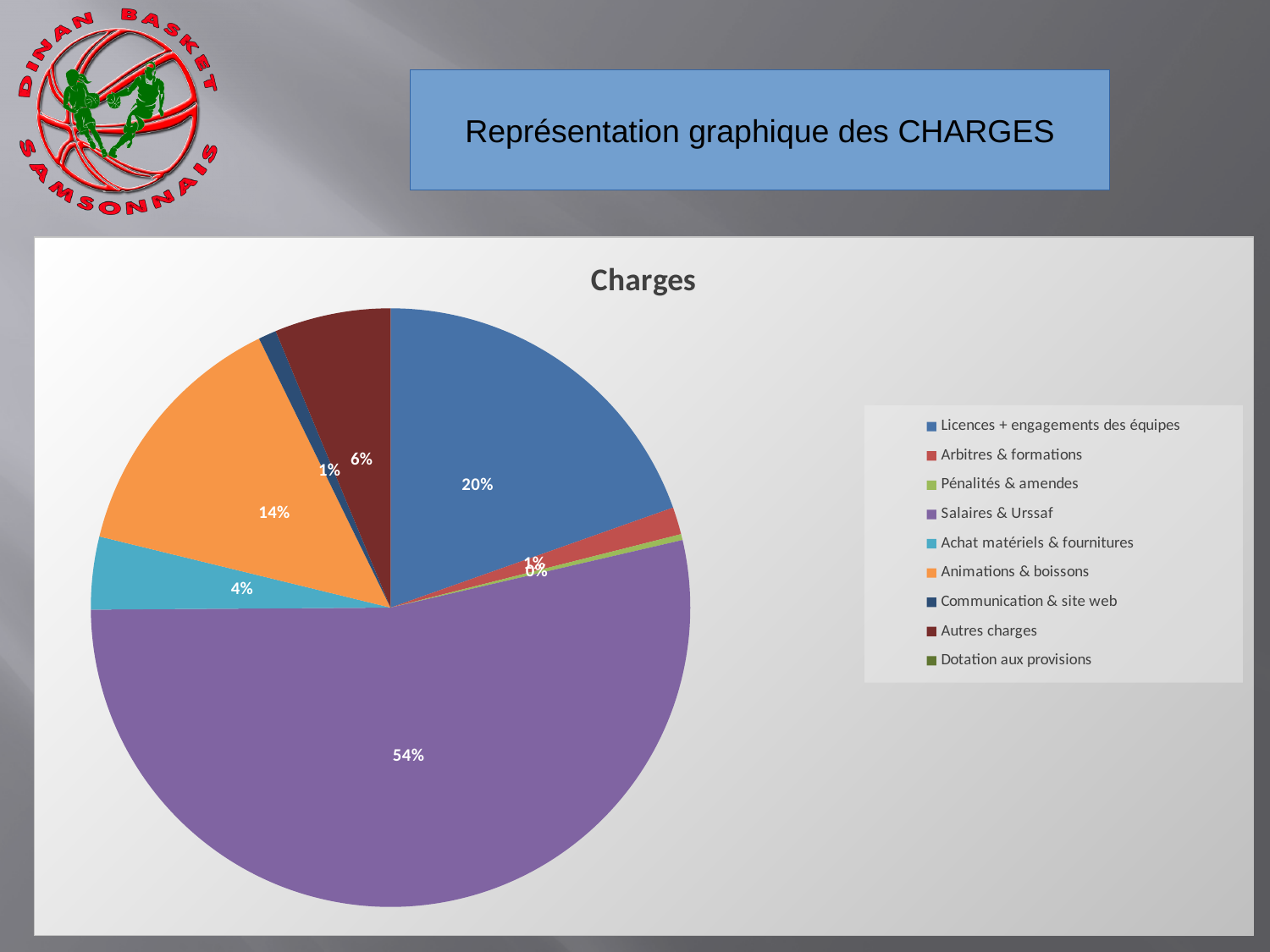
What is the title of the chart? Charges What share of the pie is Autres charges? 6% Which category has the largest share of the pie? Salaires & Urssaf What share of the pie is Achat matériels & fournitures? 4% What share of the pie is Communication & site web? 1% What kind of chart is shown on the slide? pie chart How many categories does the legend list? 9 What is the difference in percentage points between Salaires & Urssaf and Licences + engagements des équipes? 34 percentage points Which is larger, the share for Animations & boissons or the share for Autres charges? Animations & boissons